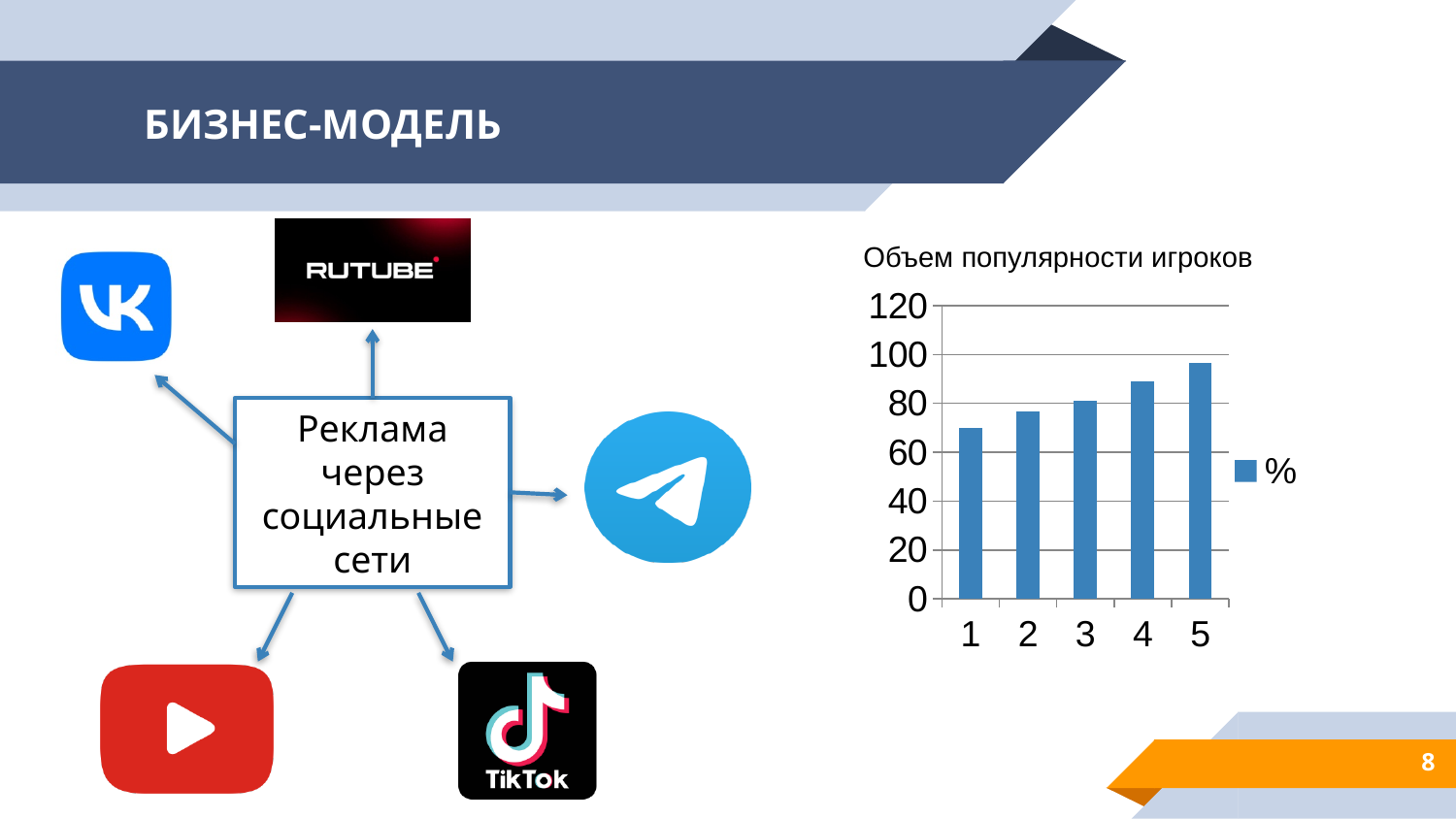
How many series does the chart's legend list? 1 Is the value for category 1 greater or less than 80? less Which category has the highest bar in the chart? 5 Is the value for category 5 greater or less than 80? greater Do the values rise or fall from category 1 to category 5? rise Is the value for category 4 greater or less than 100? less What is the legend entry for the series in the chart? % What kind of chart is shown on the slide? bar chart How many categories are plotted on the x axis of the chart? 5 What is the title of the chart on the slide? Объем популярности игроков Which is larger, the value for category 4 or the value for category 2? 4 Which category has the lowest bar in the chart? 1